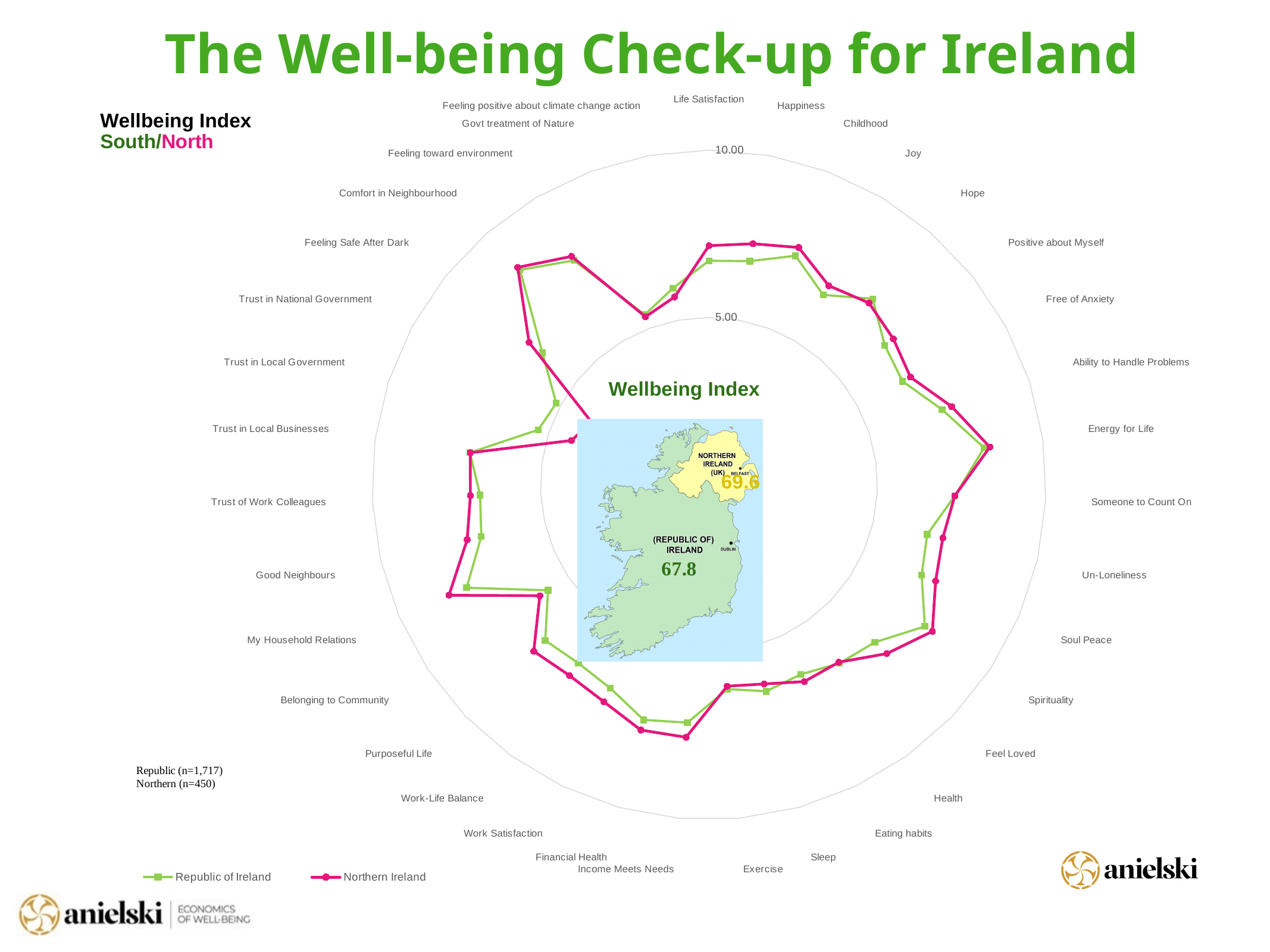
Is the Northern Ireland value for Good Neighbours greater or less than 5.00? greater Is the Republic of Ireland value for Life Satisfaction greater or less than 10.00? less Which category has the highest value for Northern Ireland? Comfort in Neighbourhood How many categories (axes) are plotted on the radar chart? 35 What Wellbeing Index value is printed for Northern Ireland on the map in the centre of the chart? 69.6 For Trust in Local Government, which series has the higher value, Republic of Ireland or Northern Ireland? Republic of Ireland For Life Satisfaction, which series has the higher value, Republic of Ireland or Northern Ireland? Northern Ireland How many series does the legend list? 2 What kind of chart is shown on the slide? Radar chart Is the Republic of Ireland value for Energy for Life greater or less than 5.00? greater Which two series are listed in the chart legend? Republic of Ireland and Northern Ireland Which category has the highest value for Republic of Ireland? Comfort in Neighbourhood